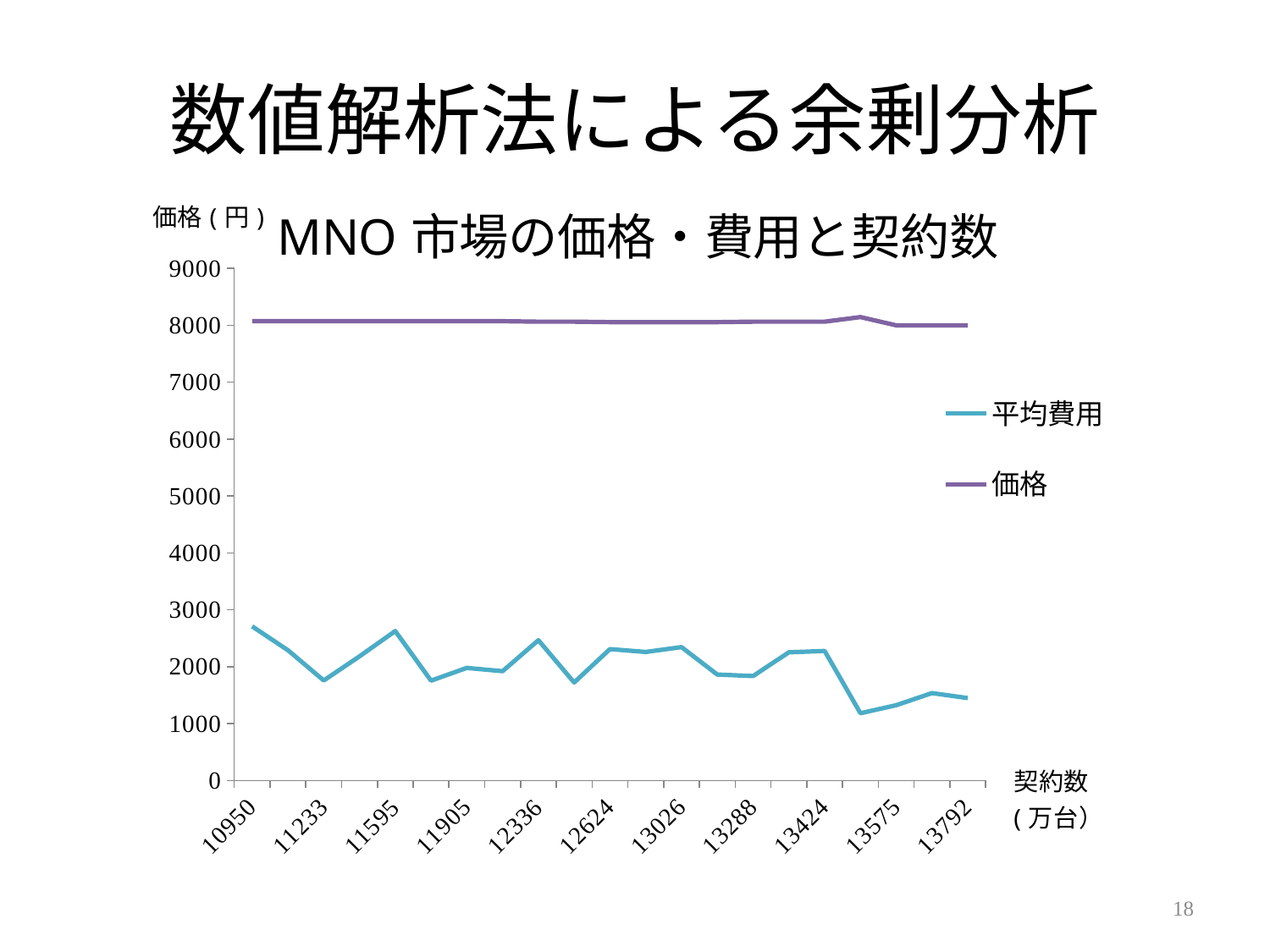
Is the value of 平均費用 at 13792 greater or less than 2000? less Is the value of 平均費用 at 10950 greater or less than 2000? greater Is the value of 価格 at 13792 greater or less than 9000? less What is the title of the chart? MNO 市場の価格・費用と契約数 What kind of chart is shown on the slide? line chart Which series is drawn in purple? 価格 Does 平均費用 overall rise or fall from the left of the x axis to the right? fall How many series does the legend list? 2 At 12336, which series has the larger value, 価格 or 平均費用? 価格